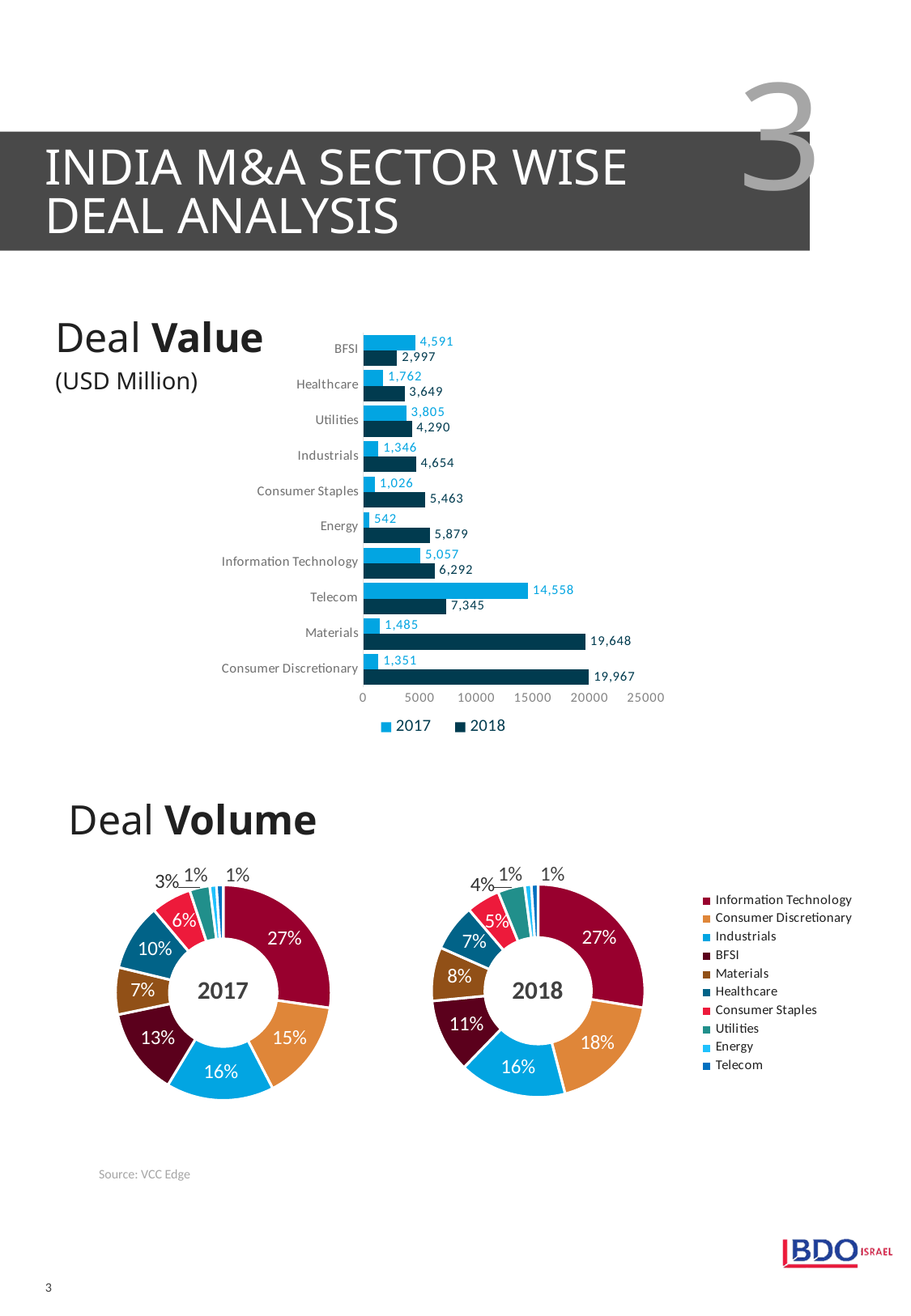
In the Deal Value chart, what is the 2018 value for Consumer Discretionary? 19,967 In the Deal Value chart, what is the difference between the 2018 and 2017 values for Materials? 18,163 In the Deal Value chart, what is the 2017 value for Telecom? 14,558 How many series does the legend of the Deal Value chart list? 2 In the 2018 Deal Volume donut chart, what share does Consumer Discretionary have? 18% What kind of chart is the Deal Value chart? Bar chart How many sectors are shown in the Deal Value chart? 10 In the 2017 Deal Volume donut chart, which sector has the largest share? Information Technology In the Deal Volume charts, is the Healthcare share larger in 2017 or in 2018? 2017 In the Deal Value chart, which sector has the highest 2018 value? Consumer Discretionary In the Deal Value chart, is the 2017 value for BFSI larger or the 2018 value for BFSI? 2017 In the Deal Value chart, which sector has the lowest 2017 value? Energy